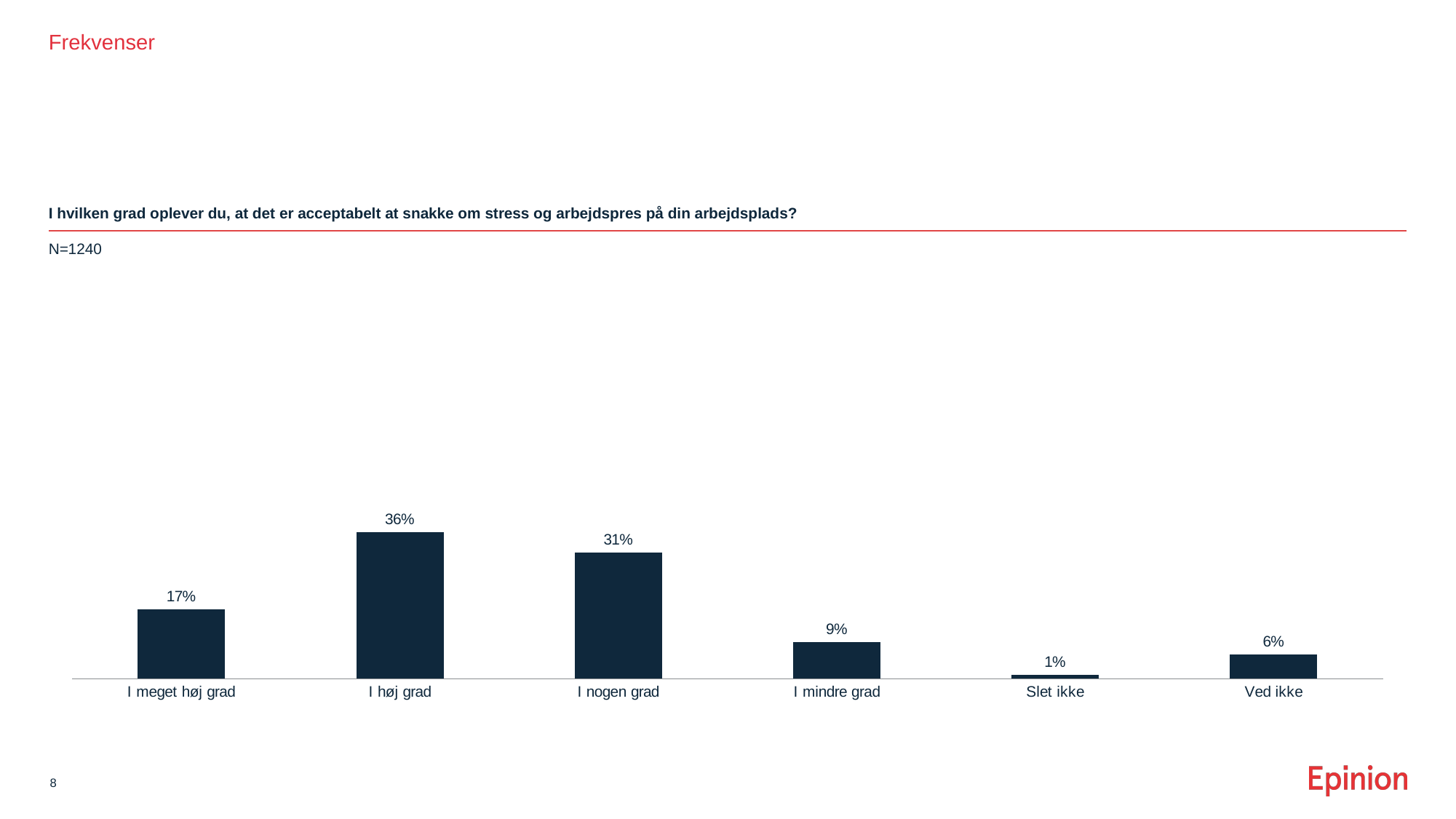
How many categories are shown in the chart? 6 What is the difference between the values for "I høj grad" and "I nogen grad"? 5% Which category has the highest value? I høj grad What is the value for "I meget høj grad"? 17% What is the value for "I høj grad"? 36% What is the value for "Ved ikke"? 6% What is the value for "Slet ikke"? 1% What kind of chart is shown on the slide? Bar chart What is the difference between the values for "I mindre grad" and "Ved ikke"? 3% What is the sample size (N) stated on the slide? N=1240 Which is larger, the value for "I meget høj grad" or the value for "I mindre grad"? I meget høj grad Which category has the lowest value? Slet ikke